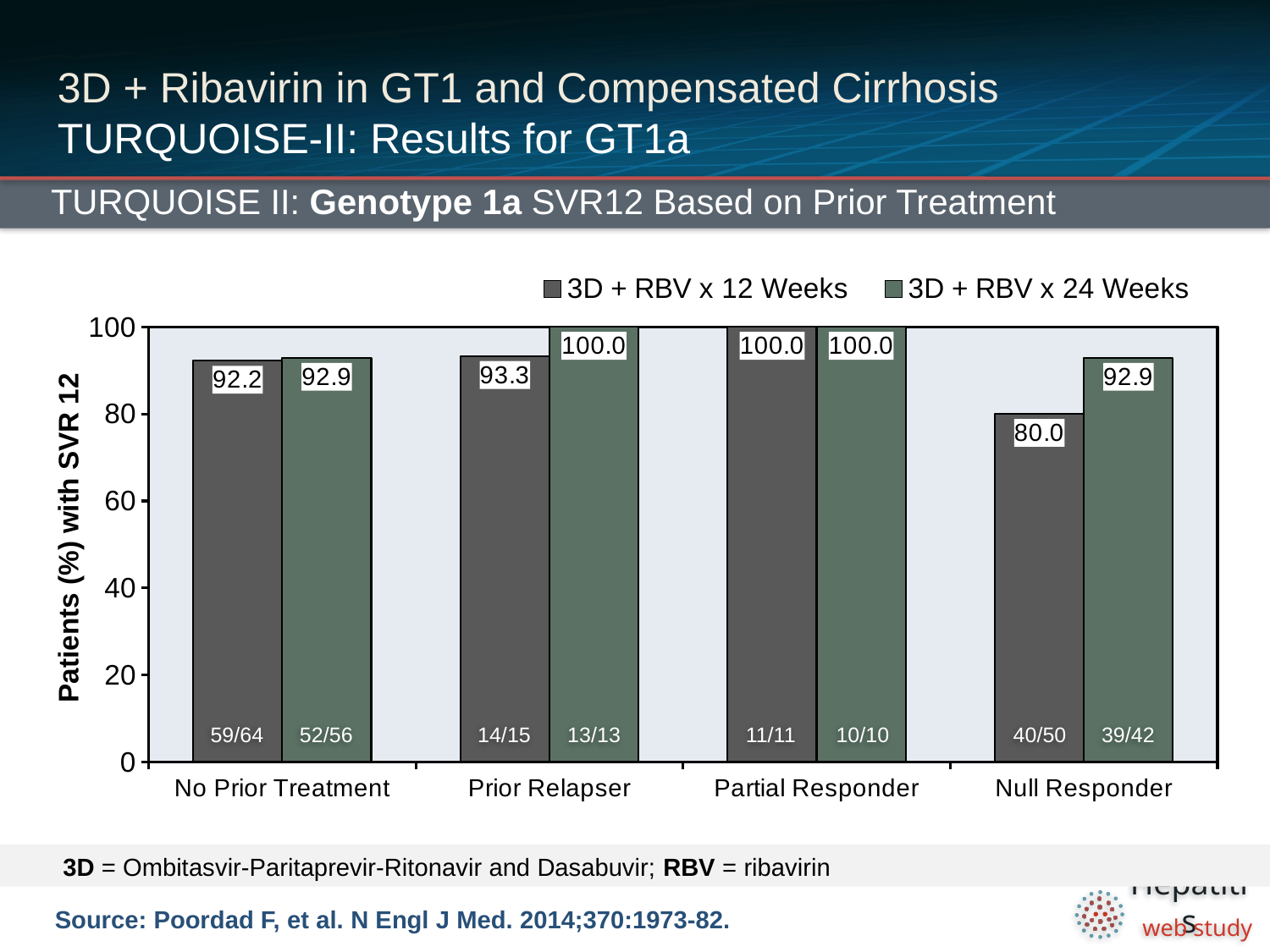
Which prior treatment category has the lowest SVR12 rate for the 3D + RBV x 12 Weeks group? Null Responder What is the SVR12 rate for the 3D + RBV x 12 Weeks group among Prior Relapsers? 93.3 What fraction of patients is shown for the 3D + RBV x 24 Weeks group among Partial Responders? 10/10 What is the difference between the 24-week and 12-week SVR12 rates among Null Responders? 12.9 What is the SVR12 rate for the 3D + RBV x 24 Weeks group among Null Responders? 92.9 What kind of chart is shown on the slide? Bar chart How many prior treatment categories are shown on the x axis? 4 What is the label of the y axis? Patients (%) with SVR 12 Which is larger among Prior Relapsers: the 12-week or the 24-week SVR12 rate? 3D + RBV x 24 Weeks How many series does the legend list? 2 What fraction of patients is shown for the 3D + RBV x 12 Weeks group among Null Responders? 40/50 What is the SVR12 rate for the 3D + RBV x 12 Weeks group among patients with No Prior Treatment? 92.2